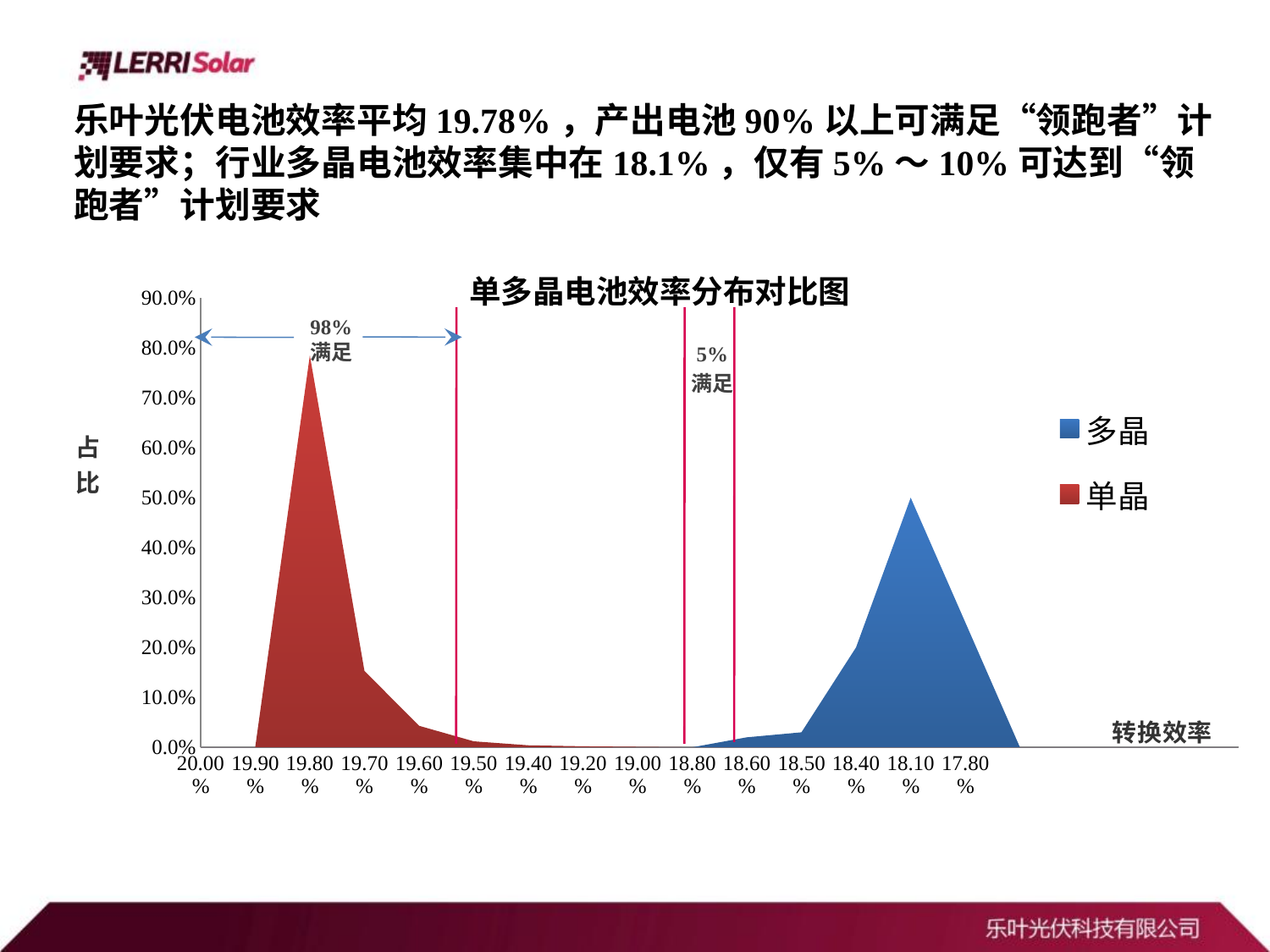
Which series is drawn in blue? 多晶 At which x-axis category does the 多晶 series reach its highest value? 18.10% At which x-axis category does the 单晶 series reach its highest value? 19.80% Is the value of the 单晶 series at 19.70% greater or less than 10.0%? greater Is the value of the 单晶 series at 19.50% greater or less than 10.0%? less Which series has the higher peak value, 单晶 or 多晶? 单晶 What kind of chart is shown on the slide? Area chart What is the title of the chart? 单多晶电池效率分布对比图 How many series does the legend list? 2 Is the peak value of the 单晶 series greater or less than 70.0%? greater How many categories are shown on the x axis? 15